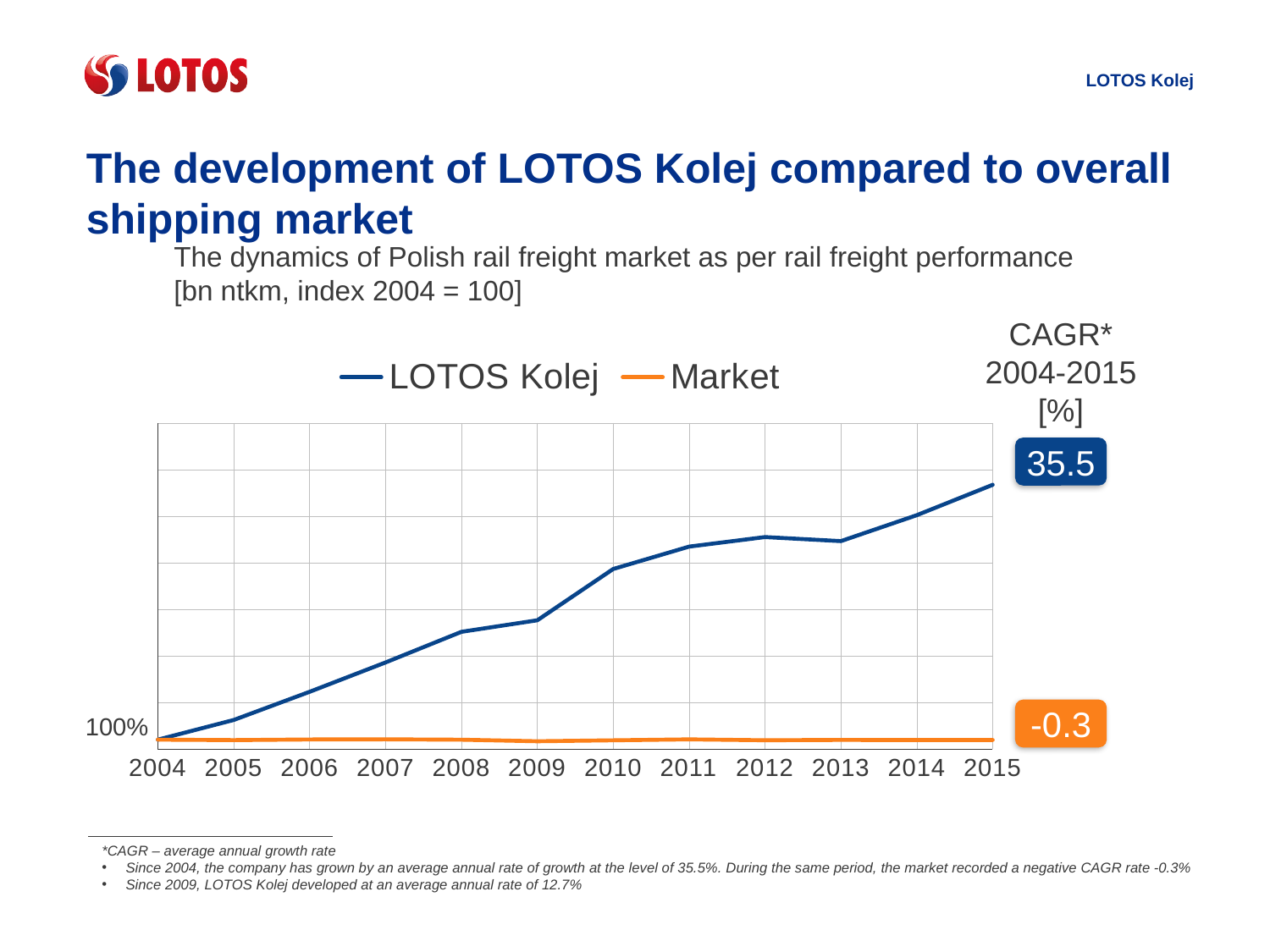
How many series does the legend list? 2 Is the value for LOTOS Kolej in 2015 greater or less than 100%? greater In which year does the LOTOS Kolej line reach its highest point? 2015 How many years are shown on the x axis of the chart? 12 What kind of chart is shown on the slide? Line chart What is the first year shown on the x axis? 2004 What CAGR for 2004-2015 [%] is shown for the Market? -0.3 What CAGR for 2004-2015 [%] is shown for LOTOS Kolej? 35.5 Which series is higher in 2015, LOTOS Kolej or Market? LOTOS Kolej Does the LOTOS Kolej line rise or fall from 2004 to 2015? Rises In which year is the LOTOS Kolej line at its lowest point? 2004 Which two series are listed in the chart legend? LOTOS Kolej and Market